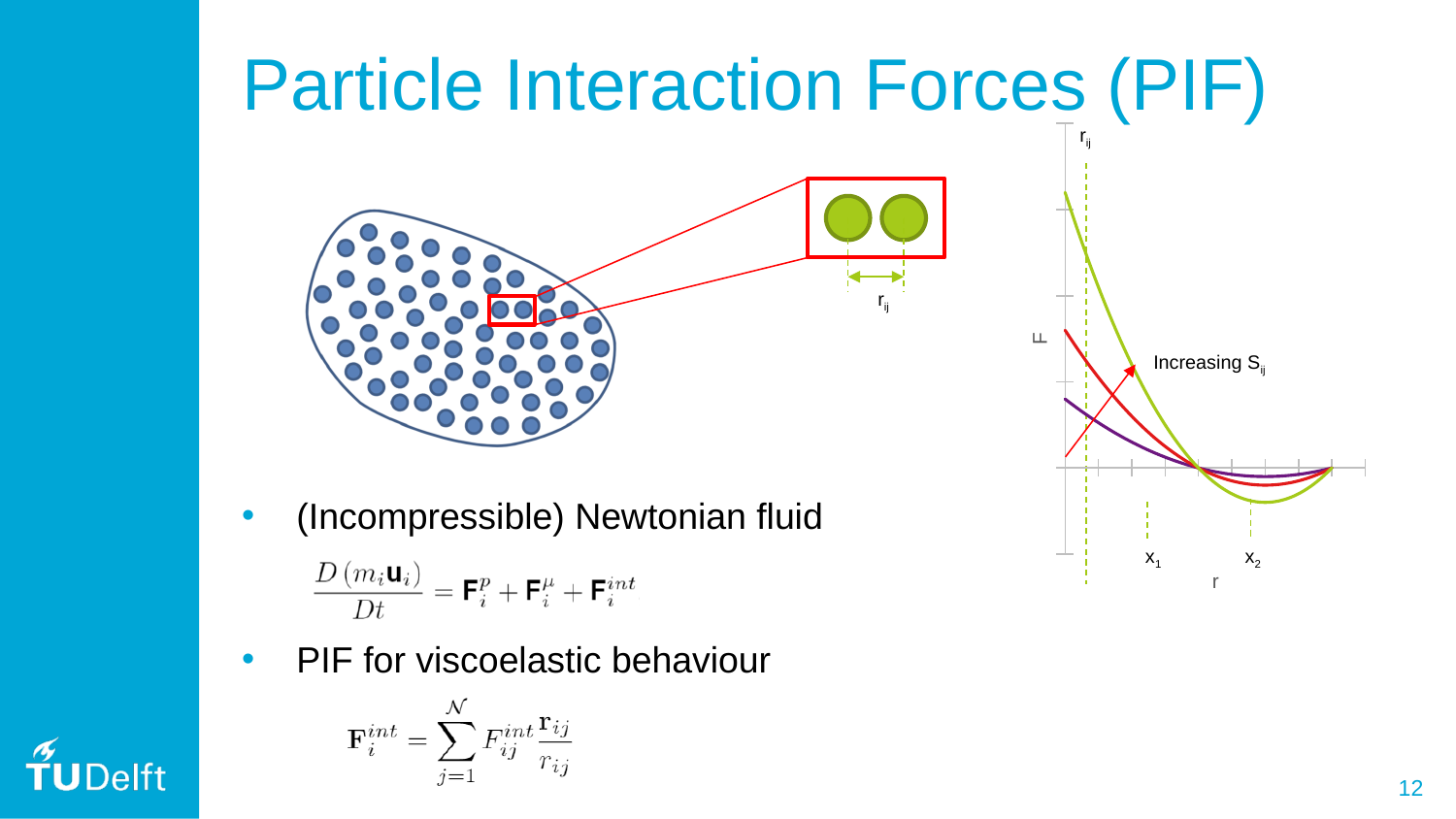
What does the arrow annotation on the chart say? Increasing Sij On the F versus r chart, which curve dips lowest below the horizontal axis: the green curve or the red curve? green What is the label on the vertical axis of the chart? F On the F versus r chart, do the curves rise or fall as r increases from the left edge toward x1? fall How many curves are plotted on the F versus r chart? 3 What kind of chart is shown on the right of the slide? line chart On the F versus r chart, which curve starts highest at the left edge: the green curve or the purple curve? green